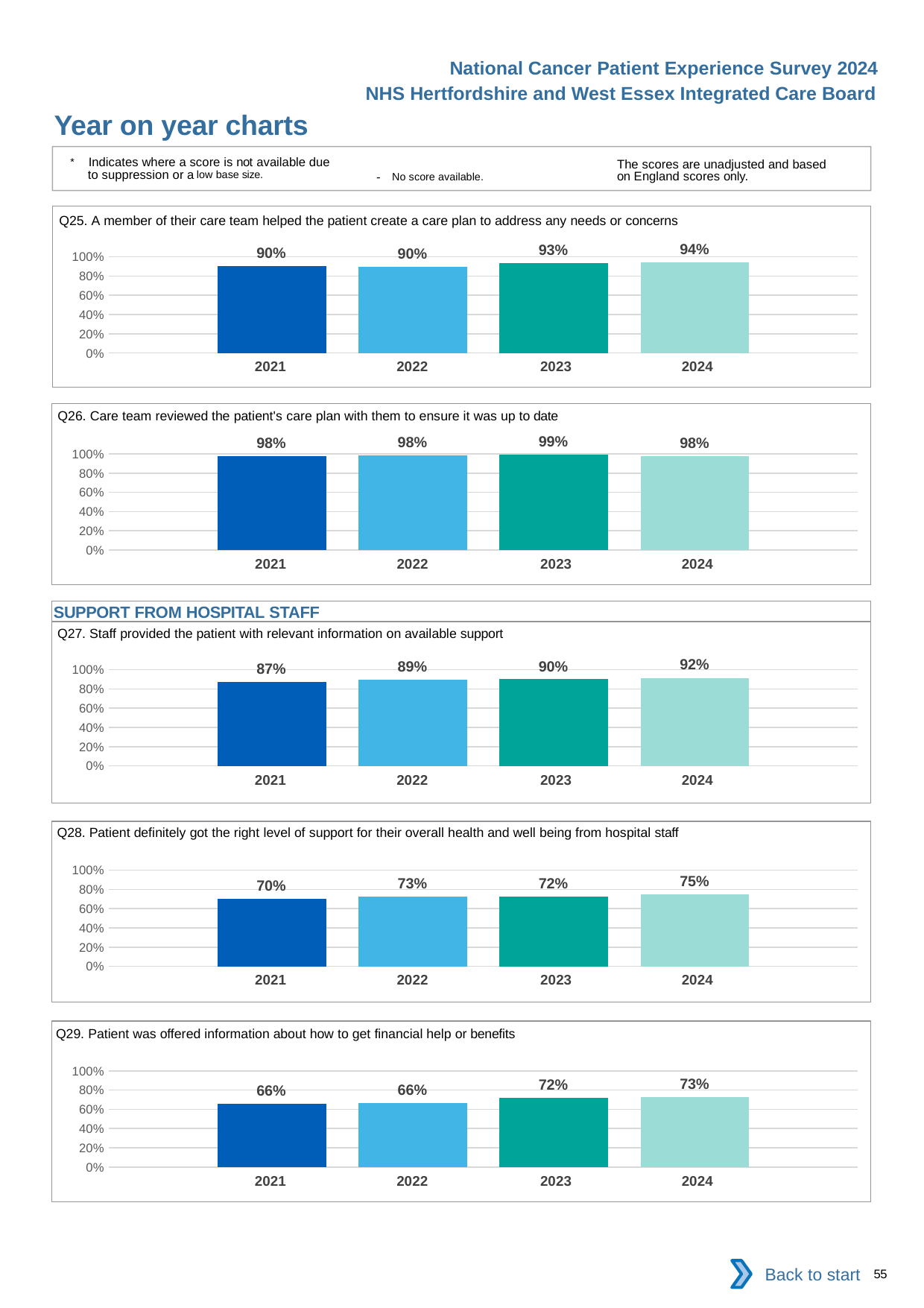
In the Q28 chart, which year has the lowest value? 2021 In the Q29 chart, what is the value for 2023? 72% In the Q25 chart, what is the value for 2024? 94% In the Q28 chart, is the value for 2022 larger or smaller than the value for 2023? larger In the Q27 chart, what is the difference between the 2024 and 2021 values? 5% How many years are shown in the Q25 chart? 4 In the Q26 chart, which year has the highest value? 2023 In the Q29 chart, is the value for 2021 greater or less than 80%? less What is the section heading shown above the Q27 chart? SUPPORT FROM HOSPITAL STAFF In the Q29 chart, what is the difference between the 2024 and 2022 values? 7% In the Q27 chart, do the values rise or fall from 2021 to 2024? rise What kind of chart is the Q27 chart? bar chart